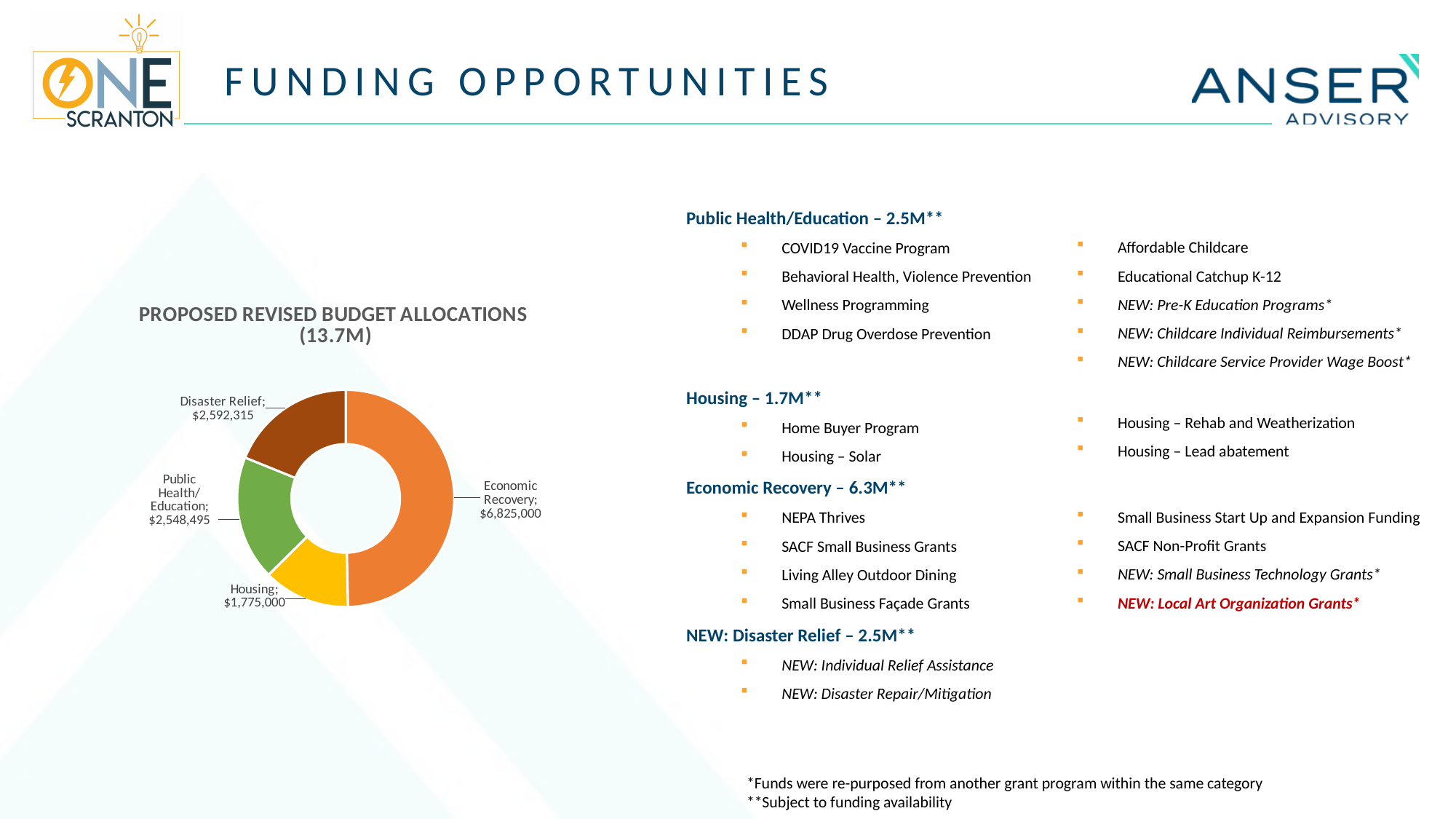
What is the value for Economic Recovery in the Proposed Revised Budget Allocations chart? $6,825,000 What is the value for Disaster Relief in the Proposed Revised Budget Allocations chart? $2,592,315 What is the difference between the Disaster Relief and Public Health/Education allocations in the chart? $43,820 What kind of chart is used to show the Proposed Revised Budget Allocations? doughnut chart Which category has the largest allocation in the Proposed Revised Budget Allocations chart? Economic Recovery What total amount is stated in the title of the Proposed Revised Budget Allocations chart? 13.7M What is the difference between the Economic Recovery and Housing allocations in the chart? $5,050,000 Which is larger in the chart, the Economic Recovery allocation or the Disaster Relief allocation? Economic Recovery How many categories are shown in the Proposed Revised Budget Allocations chart? 4 Which category has the smallest allocation in the Proposed Revised Budget Allocations chart? Housing What is the value for Public Health/Education in the Proposed Revised Budget Allocations chart? $2,548,495 What is the value for Housing in the Proposed Revised Budget Allocations chart? $1,775,000